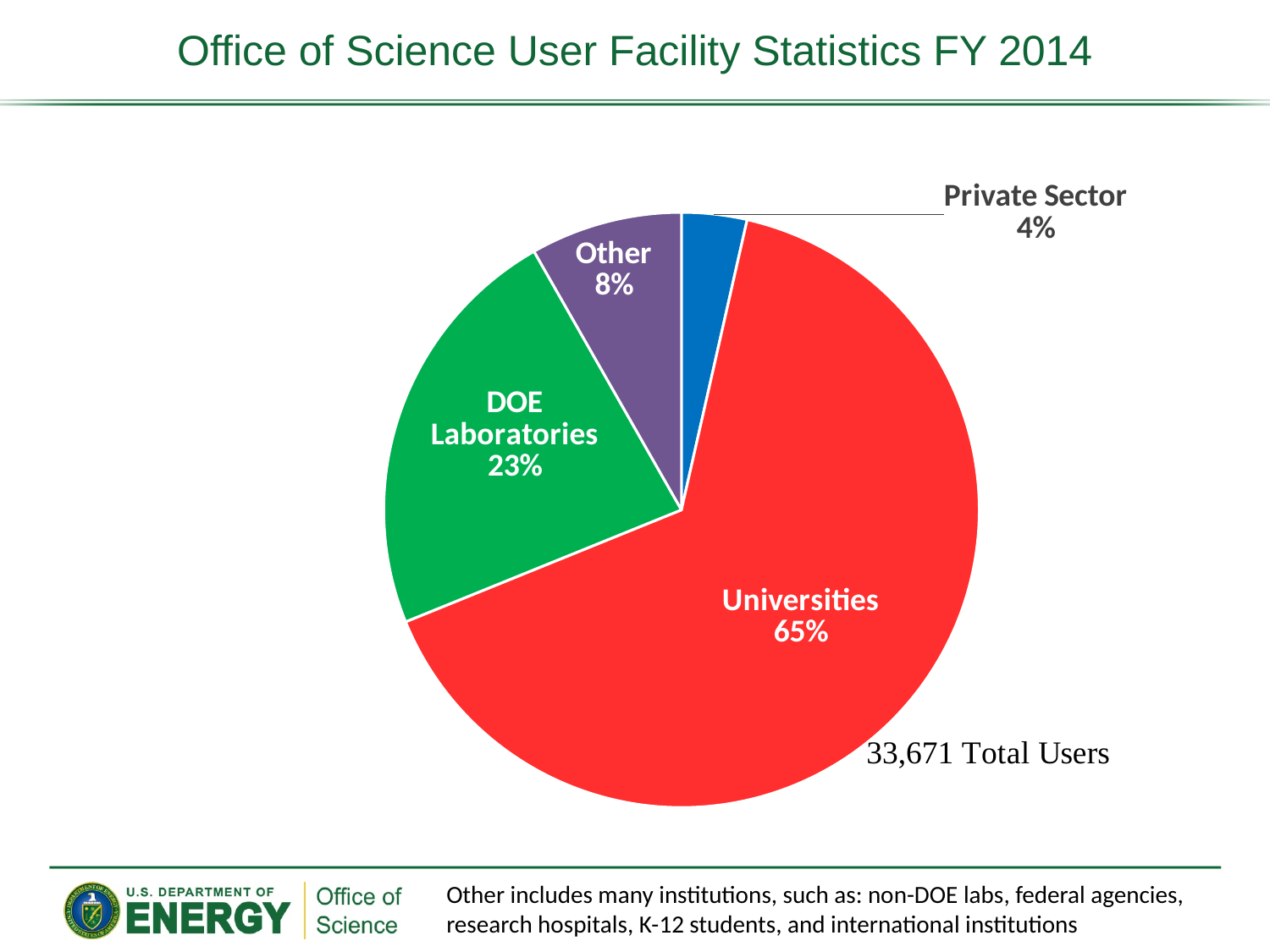
What percentage of users come from DOE Laboratories? 23% What is the total number of users stated on the slide? 33,671 What share of users do Universities account for? 65% Which is larger, the share for Other or the share for Private Sector? Other What kind of chart is shown on the slide? Pie chart Which category has the smallest share of users? Private Sector Which category has the largest share of users? Universities How many slices does the pie chart have? 4 What percentage of users are from the Private Sector? 4% What is the difference in percentage points between Universities and DOE Laboratories? 42 What colour is the Universities slice? Red What is the value shown for the Other slice? 8%